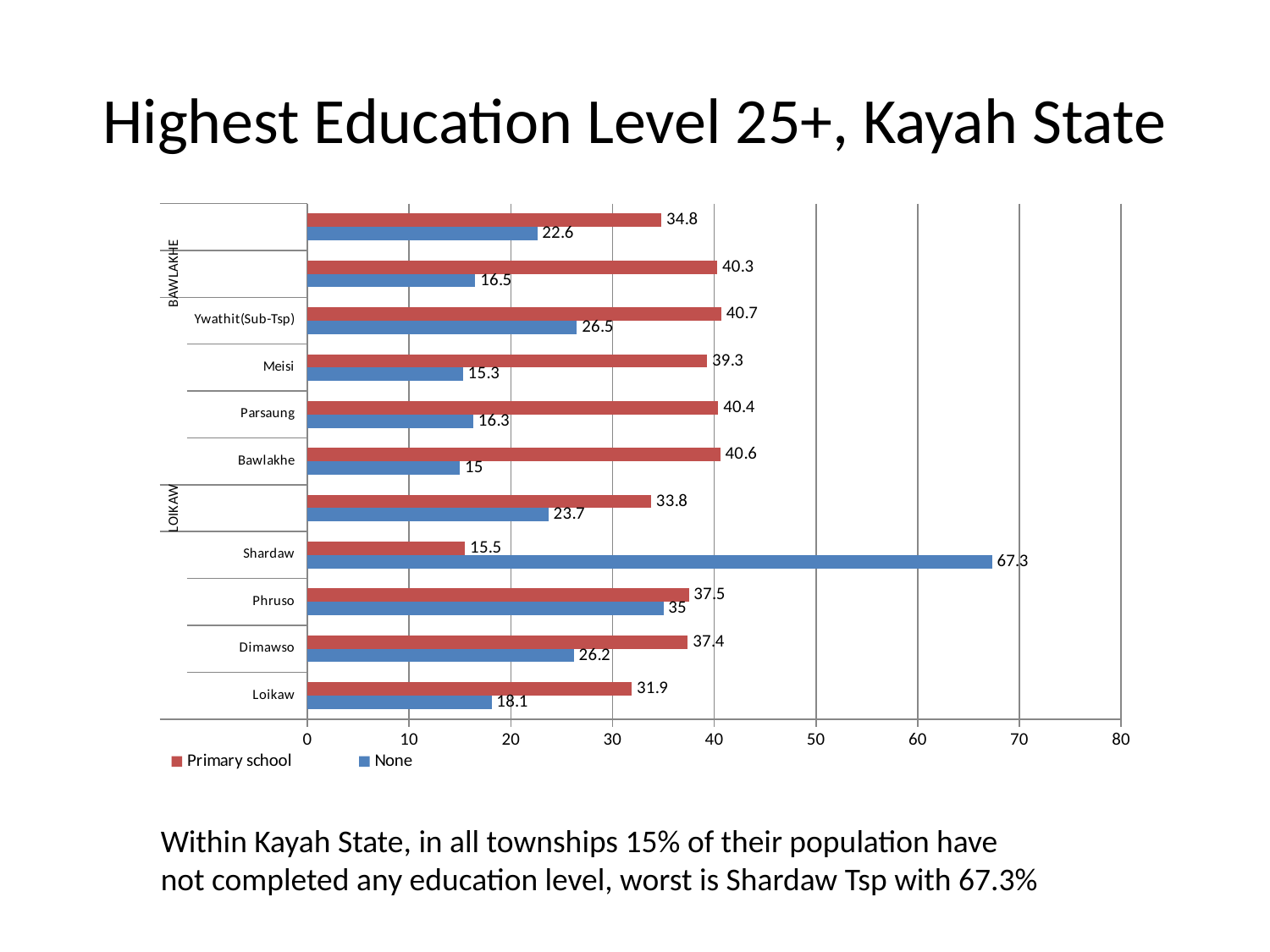
What is the value for Primary school in Ywathit(Sub-Tsp)? 40.7 How many series does the legend list? 2 Which township has the lowest value for Primary school? Shardaw What is the difference between the Primary school and None values for Loikaw? 13.8 What is the difference between the None and Primary school values for Shardaw? 51.8 Which is larger for Dimawso, Primary school or None? Primary school What kind of chart is shown on the slide? Bar chart Is the value for None in Shardaw greater or less than 60? greater What is the value for None in Shardaw? 67.3 Which township has the highest value for None? Shardaw What is the value for None in Phruso? 35 What is the value for Primary school in Loikaw? 31.9